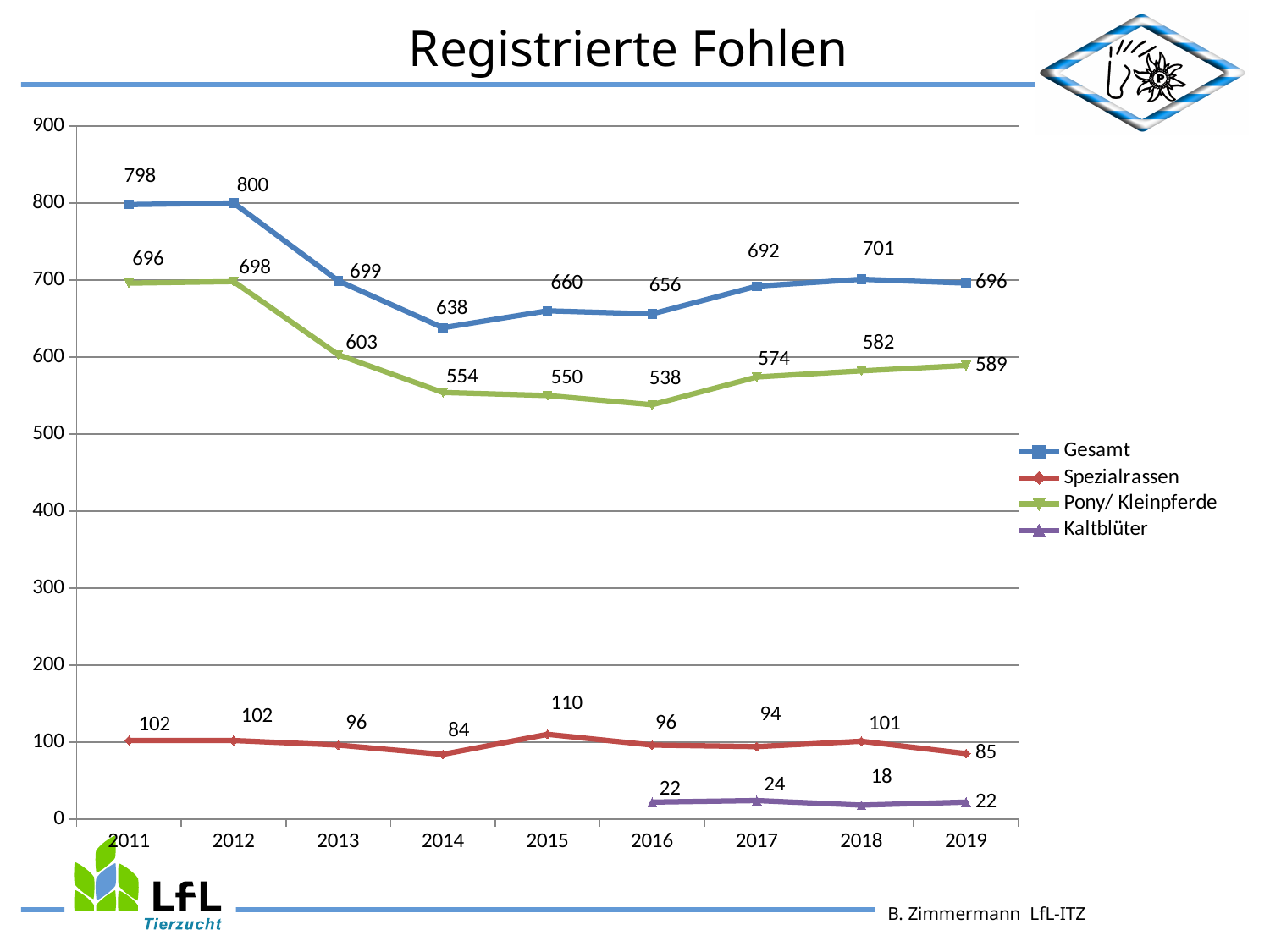
In which year is the Pony/ Kleinpferde value lowest? 2016 What type of chart is shown on the slide? line chart How many series does the legend list? 4 In which year is the Gesamt value highest? 2012 What is the difference between the Gesamt value in 2012 and in 2013? 101 What is the value for Pony/ Kleinpferde in 2016? 538 Which is larger: the Spezialrassen value in 2011 or in 2019? 2011 How many years are shown on the x axis? 9 What is the value for Kaltblüter in 2018? 18 What is the value for Gesamt in 2014? 638 What is the value for Spezialrassen in 2015? 110 What is the title of the chart? Registrierte Fohlen